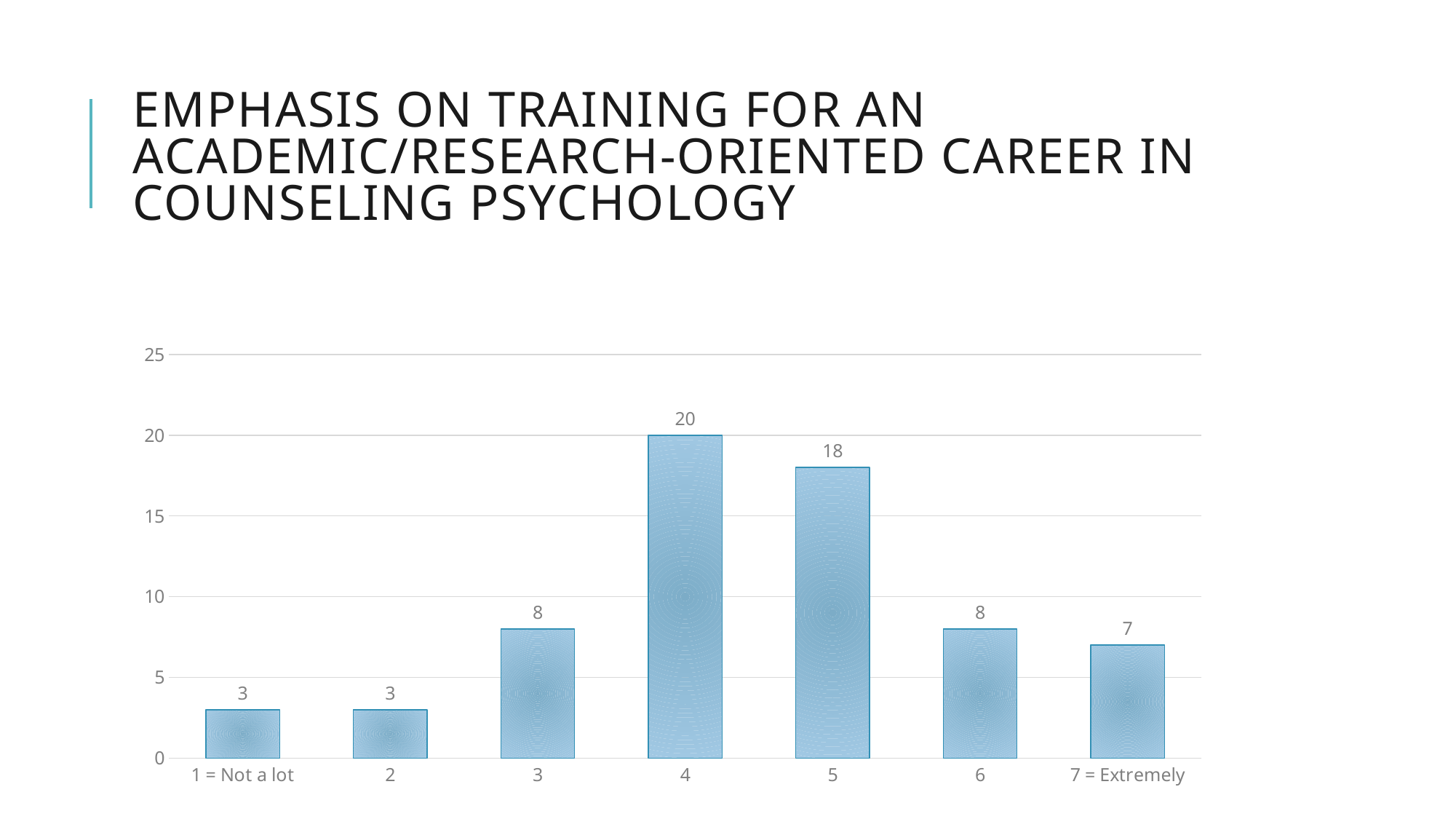
What is the value for category 4? 20 What is the title of the slide? Emphasis on Training for an Academic/Research-Oriented Career in Counseling Psychology Which category has the highest value? 4 What is the value for the category "7 = Extremely"? 7 Is the value for category 5 greater or less than 15? greater Which is larger, the value for category 3 or the value for category 5? 5 What is the difference between the values for category 4 and category 5? 2 How many categories are shown on the x axis? 7 What is the highest value shown on the y axis? 25 What is the value for the category "1 = Not a lot"? 3 What kind of chart is shown on the slide? bar chart What is the difference between the values for category 6 and category 2? 5